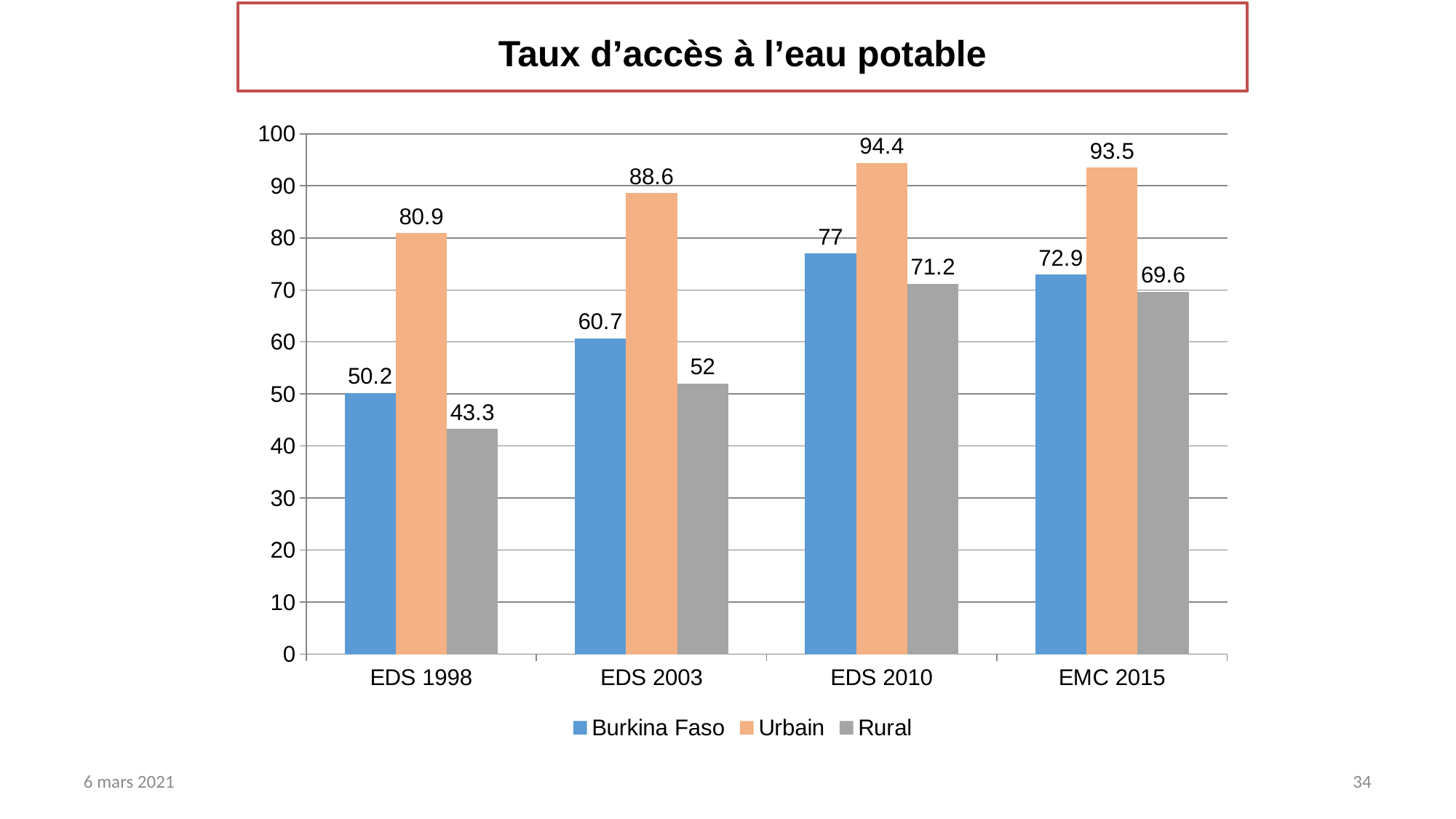
In which survey is the Urbain value highest? EDS 2010 What is the title of the chart? Taux d’accès à l’eau potable Which is larger in EDS 2010: the Burkina Faso value or the Rural value? Burkina Faso How many series does the legend list? 3 What is the value for Urbain in EDS 2010? 94.4 What is the difference between the Urbain and Rural values in EDS 2003? 36.6 What is the value for Rural in EDS 1998? 43.3 What kind of chart is shown on the slide? Bar chart How many surveys (categories) are shown on the x axis? 4 What is the value for Burkina Faso in EMC 2015? 72.9 Does the Rural value rise or fall from EDS 1998 to EDS 2010? Rise In which survey is the Rural value lowest? EDS 1998